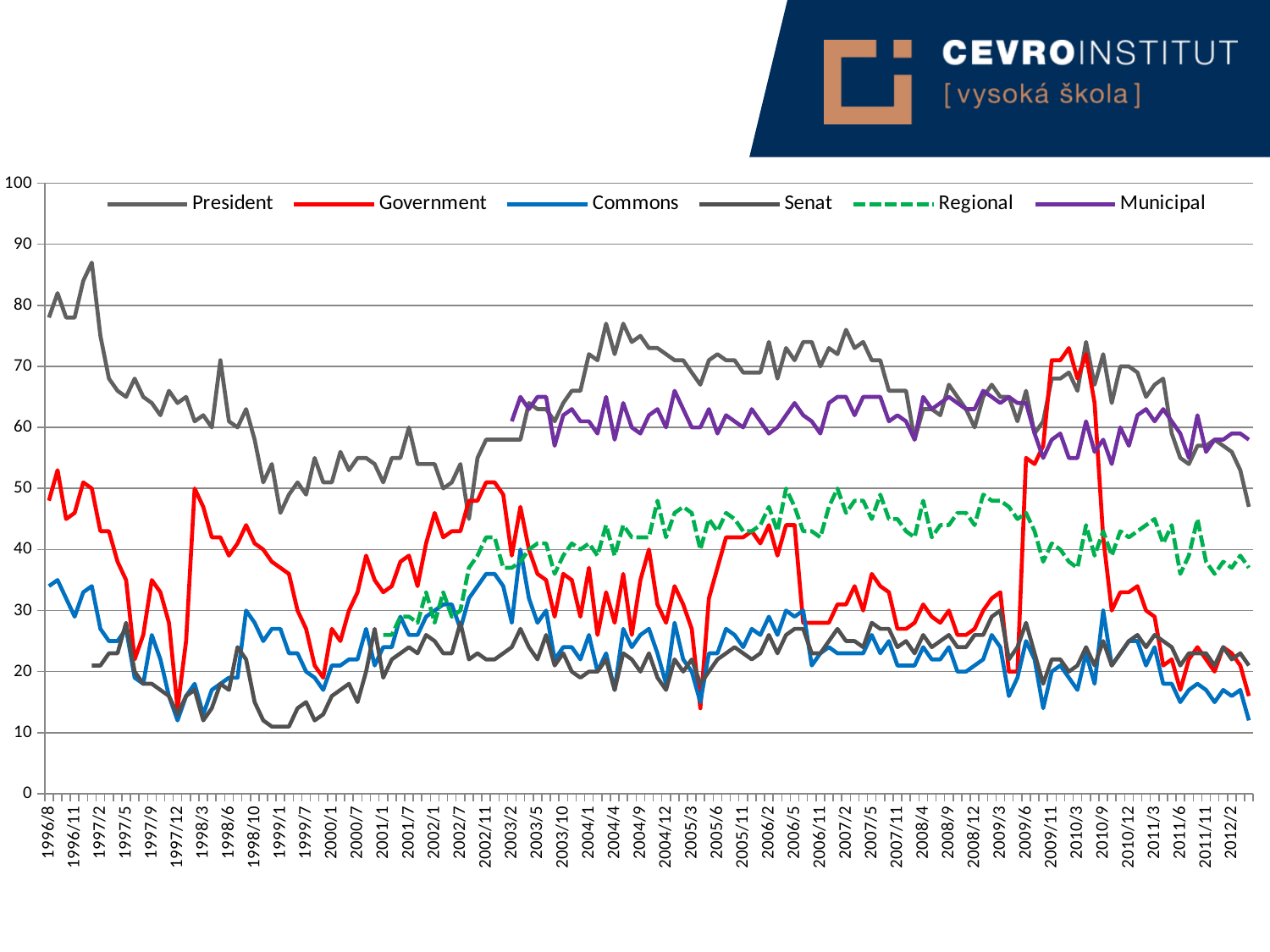
Which series has the highest value at 2004/4? President Does the President series rise or fall between 1996/8 and 1999/1? fall Which series is drawn with a dashed line? Regional What kind of chart is shown on the slide? line chart At 2007/2, which is larger, the Regional value or the Municipal value? Municipal Is the value for Senat at 1999/1 greater or less than 20? less Is the value for President at 2004/4 greater or less than 70? greater Which series has the lowest value at 2012/2? Commons How many series does the legend list? 6 What is the highest value shown on the vertical axis? 100 Is the value for President at 1996/8 greater or less than 70? greater